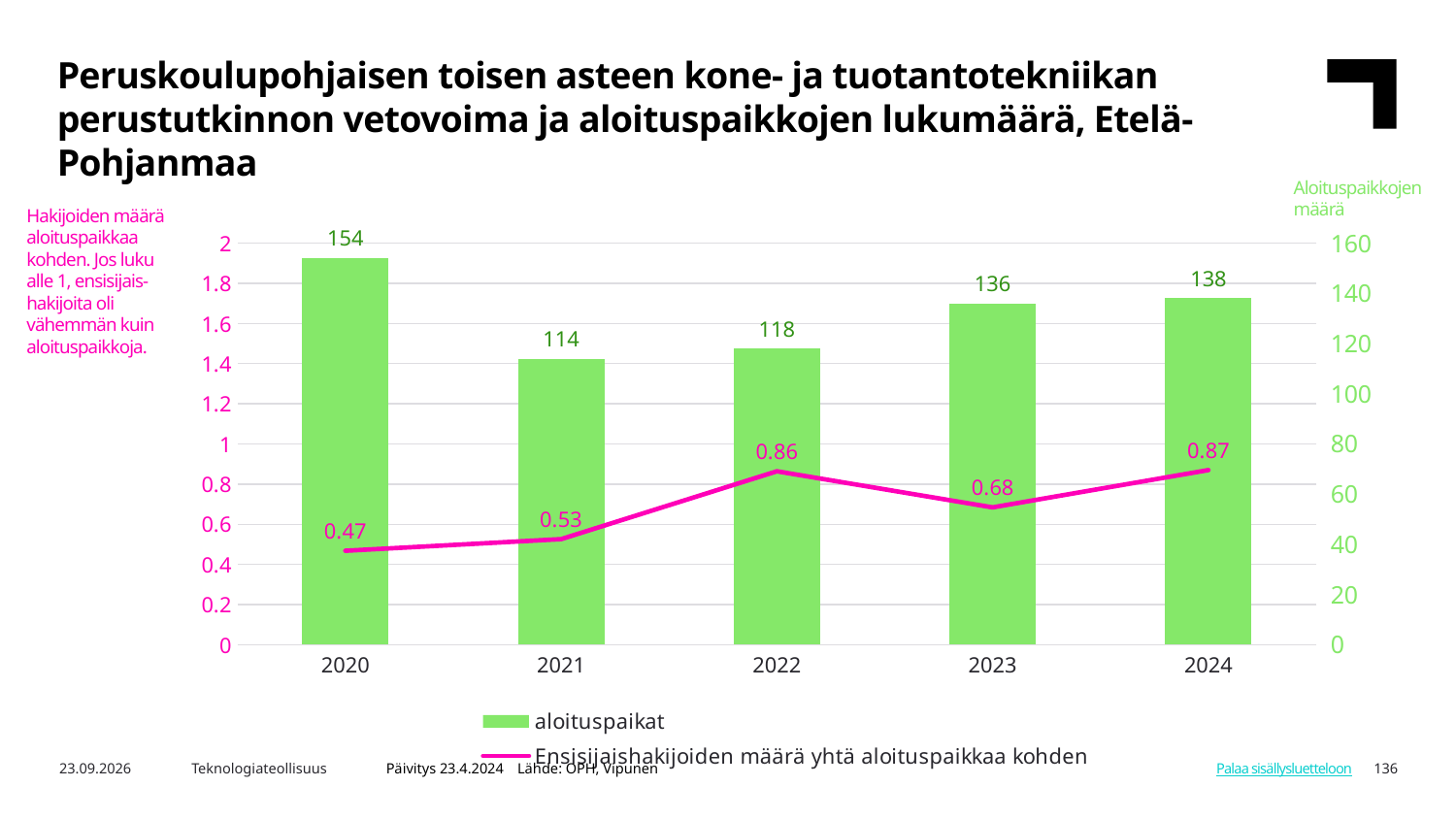
Is the value of aloituspaikat for 2021 greater or less than 120? less How many years are shown on the x axis? 5 Which year has the lowest value of Ensisijaishakijoiden määrä yhtä aloituspaikkaa kohden? 2020 What is the difference in aloituspaikat between 2020 and 2021? 40 What colour is the line for Ensisijaishakijoiden määrä yhtä aloituspaikkaa kohden? pink What is the value of aloituspaikat for 2020? 154 Which year has the highest value of aloituspaikat? 2020 How many series does the legend list? 2 What kind of chart is used to show the aloituspaikat series? bar chart What is the value of Ensisijaishakijoiden määrä yhtä aloituspaikkaa kohden for 2022? 0.86 Which year has a larger value of aloituspaikat, 2022 or 2024? 2024 What is the value of aloituspaikat for 2023? 136